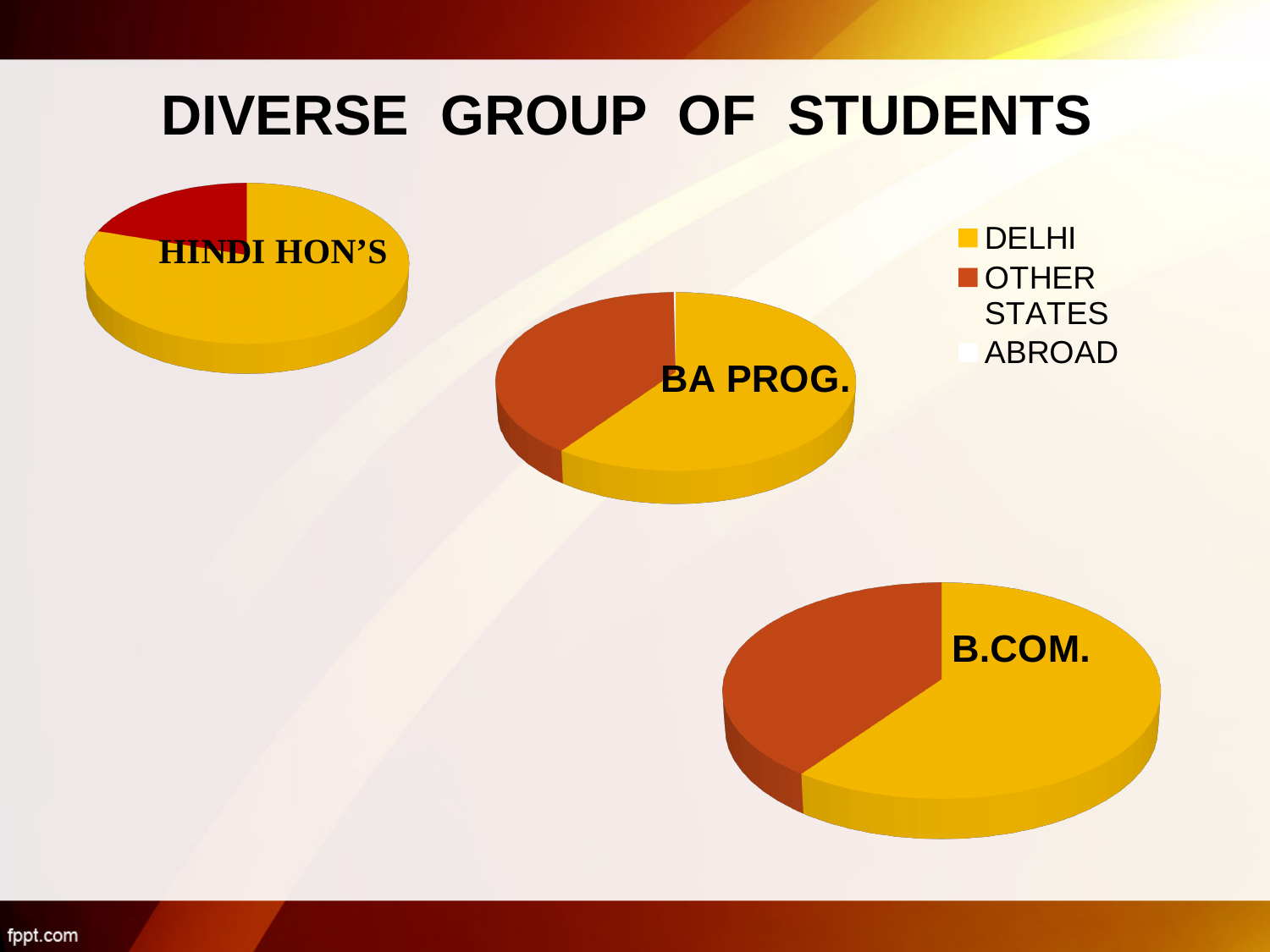
In the BA PROG. pie chart, which category has the largest slice? DELHI Which of the three pie charts is positioned at the bottom right of the slide? B.COM. How many categories does the legend list? 3 In the BA PROG. pie chart, which is larger: the DELHI slice or the OTHER STATES slice? DELHI In the HINDI HON'S pie chart, which category has the largest slice? DELHI What is the title of the slide containing the three pie charts? DIVERSE GROUP OF STUDENTS In the B.COM. pie chart, which is larger: the DELHI slice or the OTHER STATES slice? DELHI Which legend entry is shown in yellow? DELHI What kind of chart is used for the HINDI HON'S data? Pie chart How many pie charts are shown on the slide? 3 In the B.COM. pie chart, which category has the largest slice? DELHI